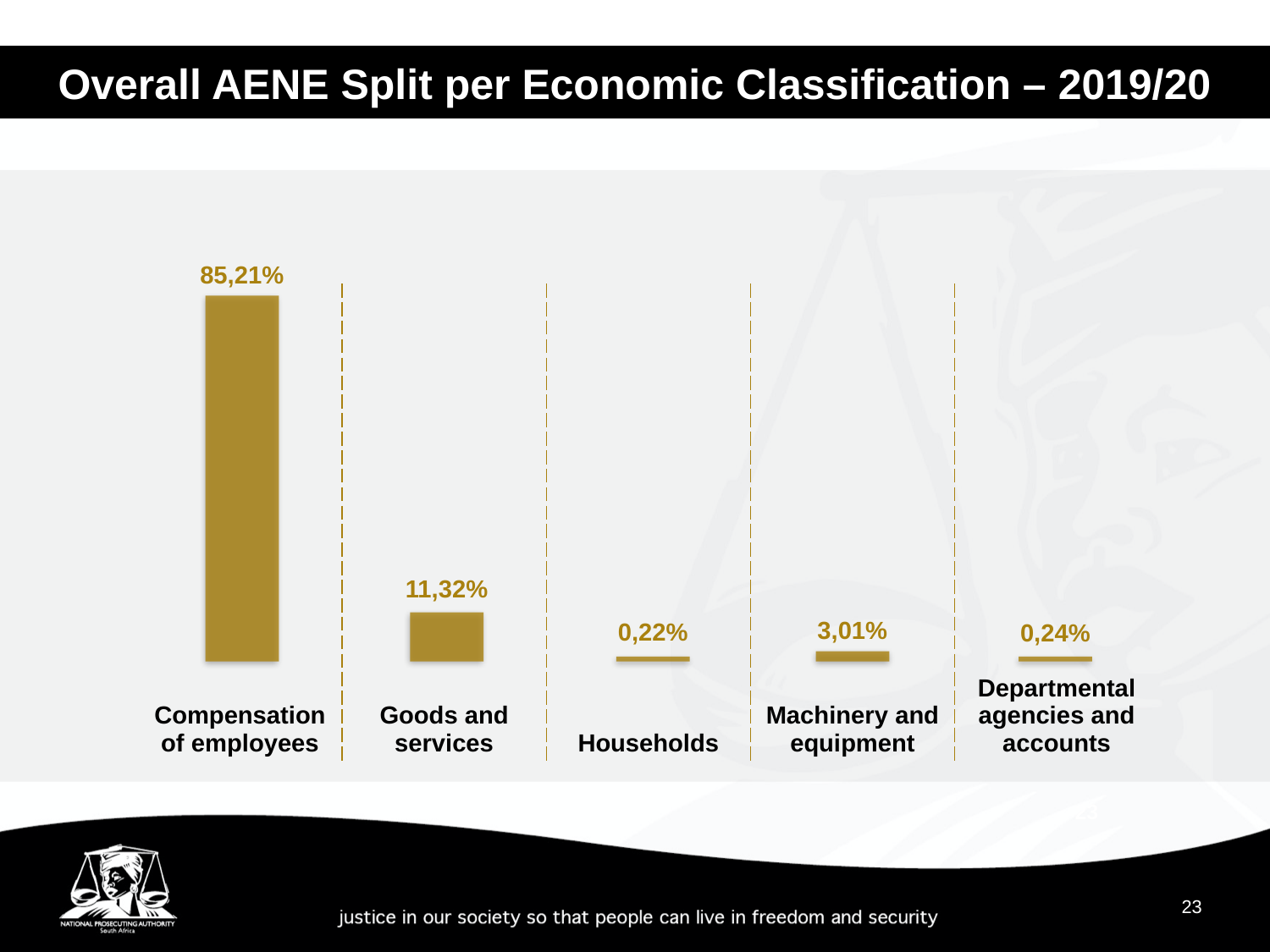
What is the value for Departmental agencies and accounts? 0,24% How many categories are shown in the chart? 5 What is the value for Compensation of employees? 85,21% What is the title of the slide? Overall AENE Split per Economic Classification – 2019/20 Which category has the lowest value? Households Which category has the highest value? Compensation of employees What is the value for Machinery and equipment? 3,01% What kind of chart is shown on the slide? Bar chart Which is larger, the value for Machinery and equipment or the value for Goods and services? Goods and services What is the value for Households? 0,22% What is the difference between the values for Compensation of employees and Goods and services? 73,89% What is the value for Goods and services? 11,32%